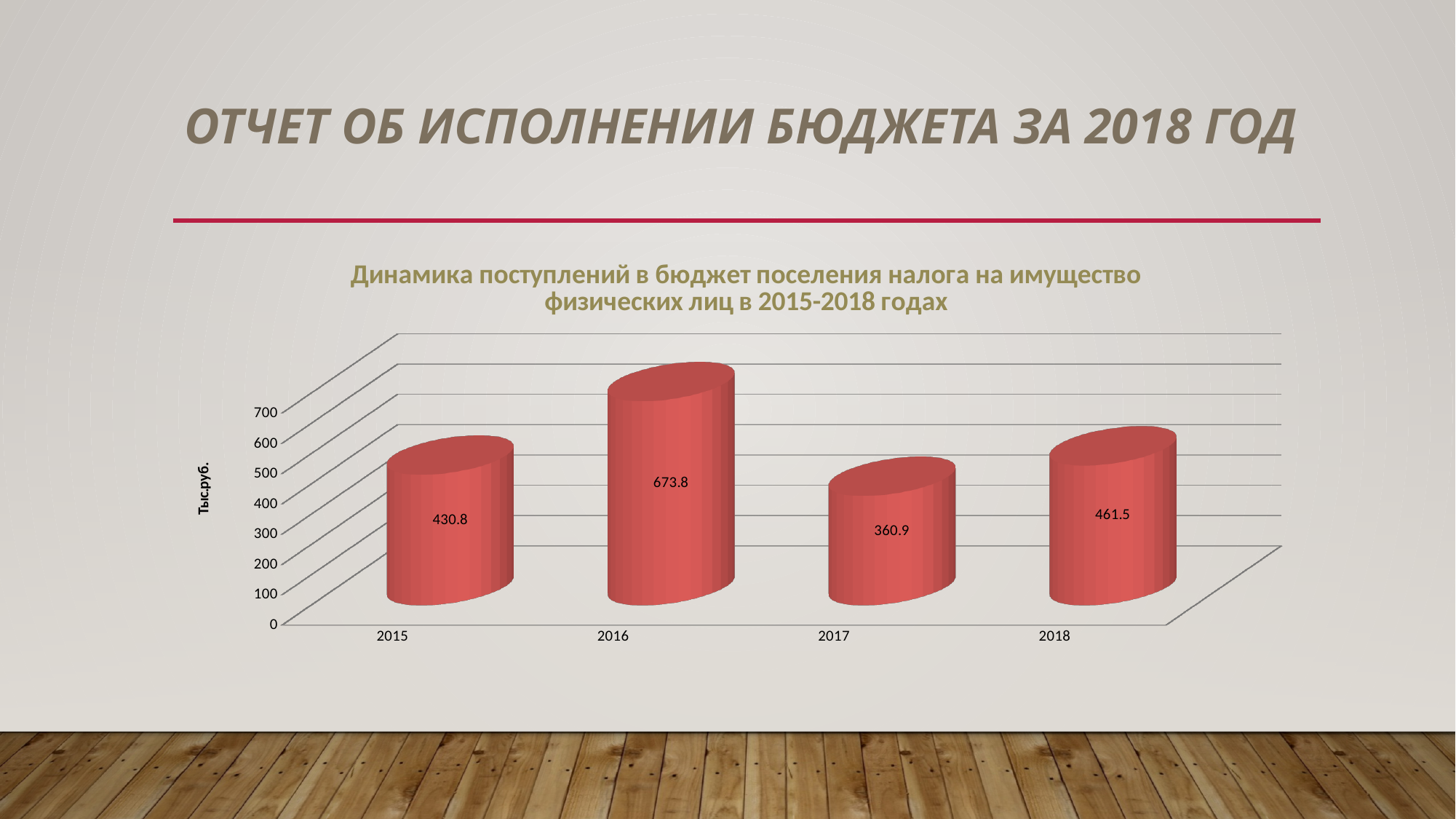
Which year has the lowest value? 2017 What is the value for 2016? 673.8 What is the difference between the values for 2018 and 2015? 30.7 How many years are shown on the x axis? 4 Which year has the highest value? 2016 What is the difference between the values for 2016 and 2017? 312.9 What is the value for 2018? 461.5 What is the value for 2017? 360.9 What is the y-axis label of the chart? Тыс.руб. Which is larger, the value for 2015 or the value for 2018? 2018 What is the value for 2015? 430.8 What kind of chart is this? bar chart